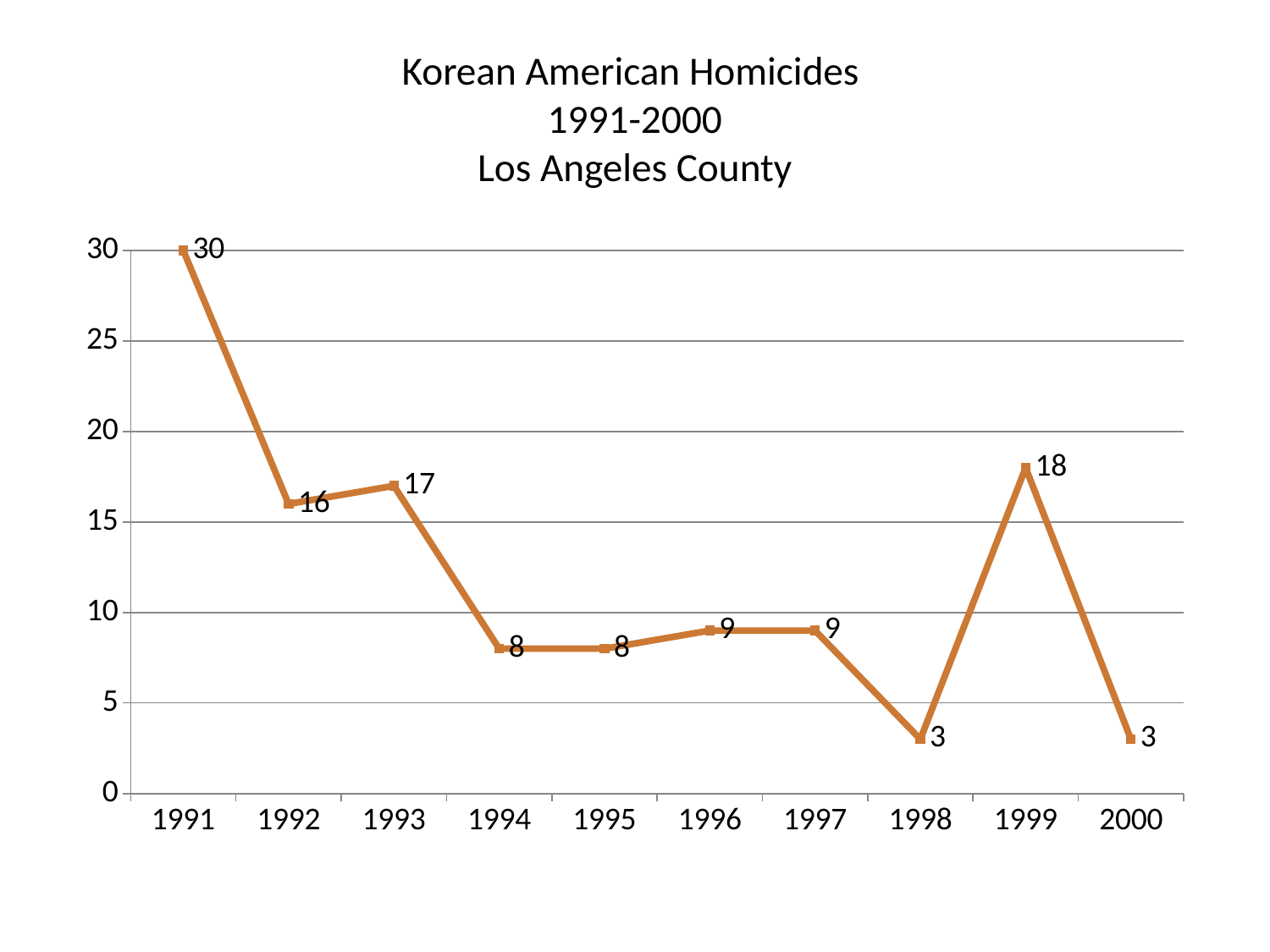
Do the values rise or fall from 1991 to 1994? Fall What is the difference between the values for 1991 and 1992? 14 What is the value shown for 1993? 17 What is the difference between the values for 1999 and 2000? 15 How many years are plotted on the x axis? 10 Which year has the highest number of homicides? 1991 What is the lowest value plotted on the chart? 3 Which year has the larger value, 1993 or 1996? 1993 What is the value shown for 1999? 18 Is the value for 1999 greater or less than 15? greater What kind of chart is shown on the slide? Line chart What is the number of Korean American homicides in 1991? 30